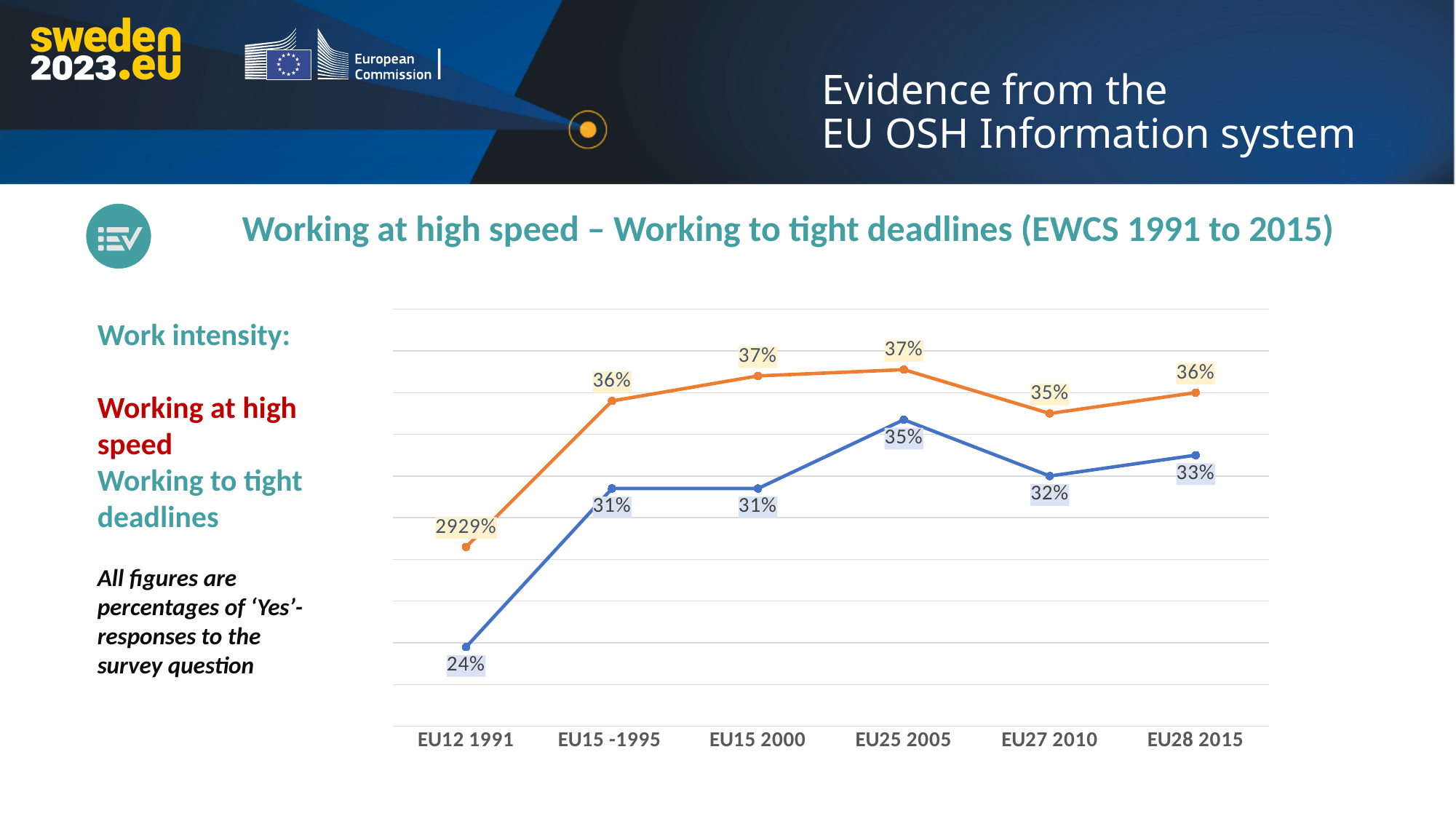
What is the difference between the orange and blue values at EU28 2015? 3 percentage points What is the title of the chart section on the slide? Working at high speed – Working to tight deadlines (EWCS 1991 to 2015) At which survey wave does the blue line reach its highest value? EU25 2005 What kind of chart is shown on the slide? Line chart Does the blue line rise or fall between EU12 1991 and EU15 -1995? Rise What is the value of the orange line at EU25 2005? 37% How many survey waves (x-axis categories) are plotted on the chart? 6 At EU15 2000, which line has the higher value, orange or blue? Orange At which survey wave is the orange line at its lowest value? EU12 1991 What is the value of the blue line at EU12 1991? 24% What is the value of the orange line at EU15 -1995? 36% What is the value of the blue line at EU27 2010? 32%